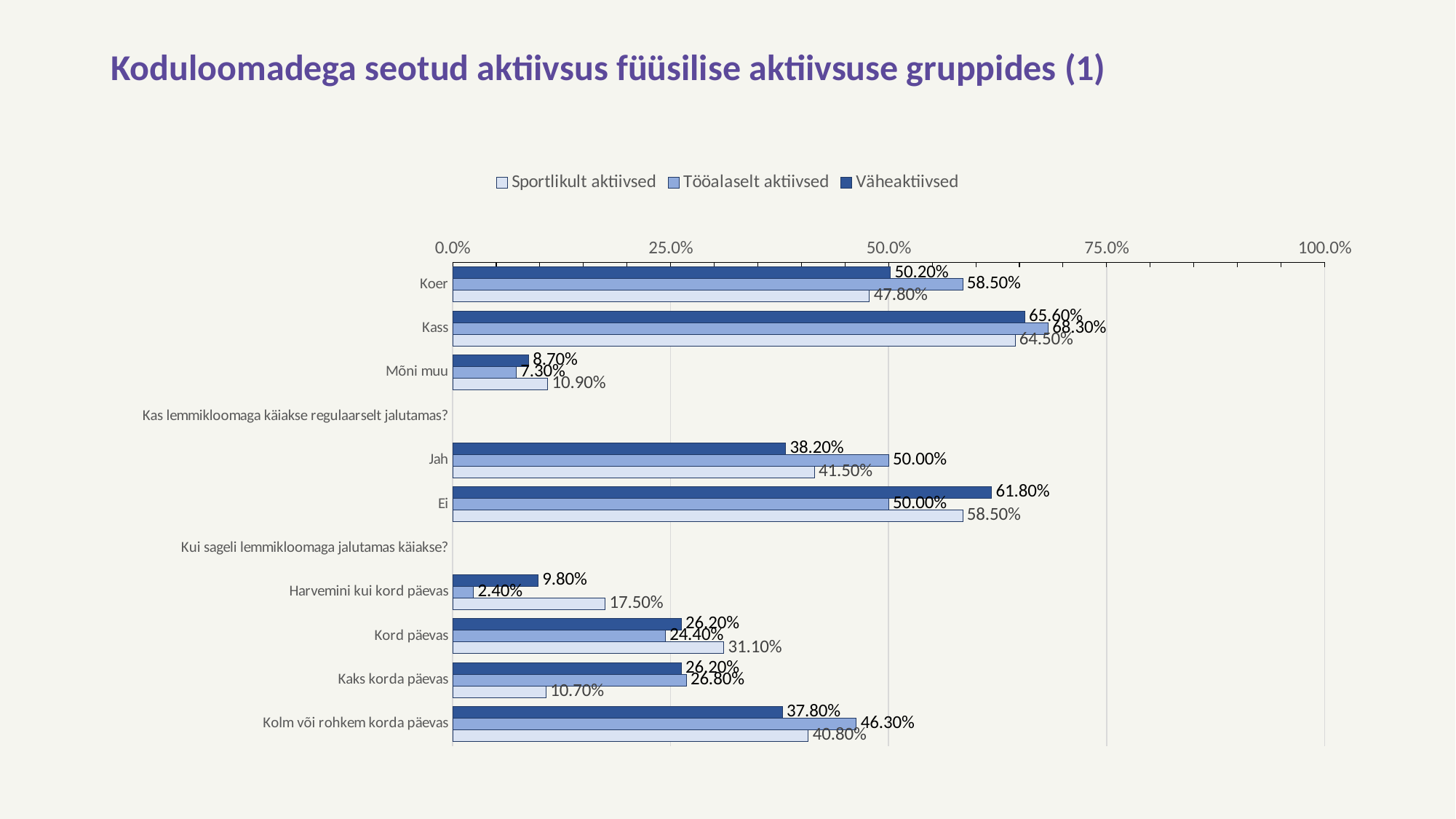
What kind of chart is shown on the slide? bar chart Is the Tööalaselt aktiivsed value for Kass greater or less than 50.0%? greater What is the title of the chart on the slide? Koduloomadega seotud aktiivsus füüsilise aktiivsuse gruppides (1) Which series has the highest value in the Kolm või rohkem korda päevas category? Tööalaselt aktiivsed How many series does the legend list? 3 What is the value for Sportlikult aktiivsed in the Kass category? 64.50% Which is larger: the Sportlikult aktiivsed value for Kord päevas or for Kaks korda päevas? Kord päevas What is the value for Väheaktiivsed in the Ei category? 61.80% What is the difference between the Väheaktiivsed values for Ei and Jah? 23.60% What is the value for Tööalaselt aktiivsed in the Harvemini kui kord päevas category? 2.40% What is the value for Väheaktiivsed in the Koer category? 50.20% Which series has the lowest value in the Kaks korda päevas category? Sportlikult aktiivsed